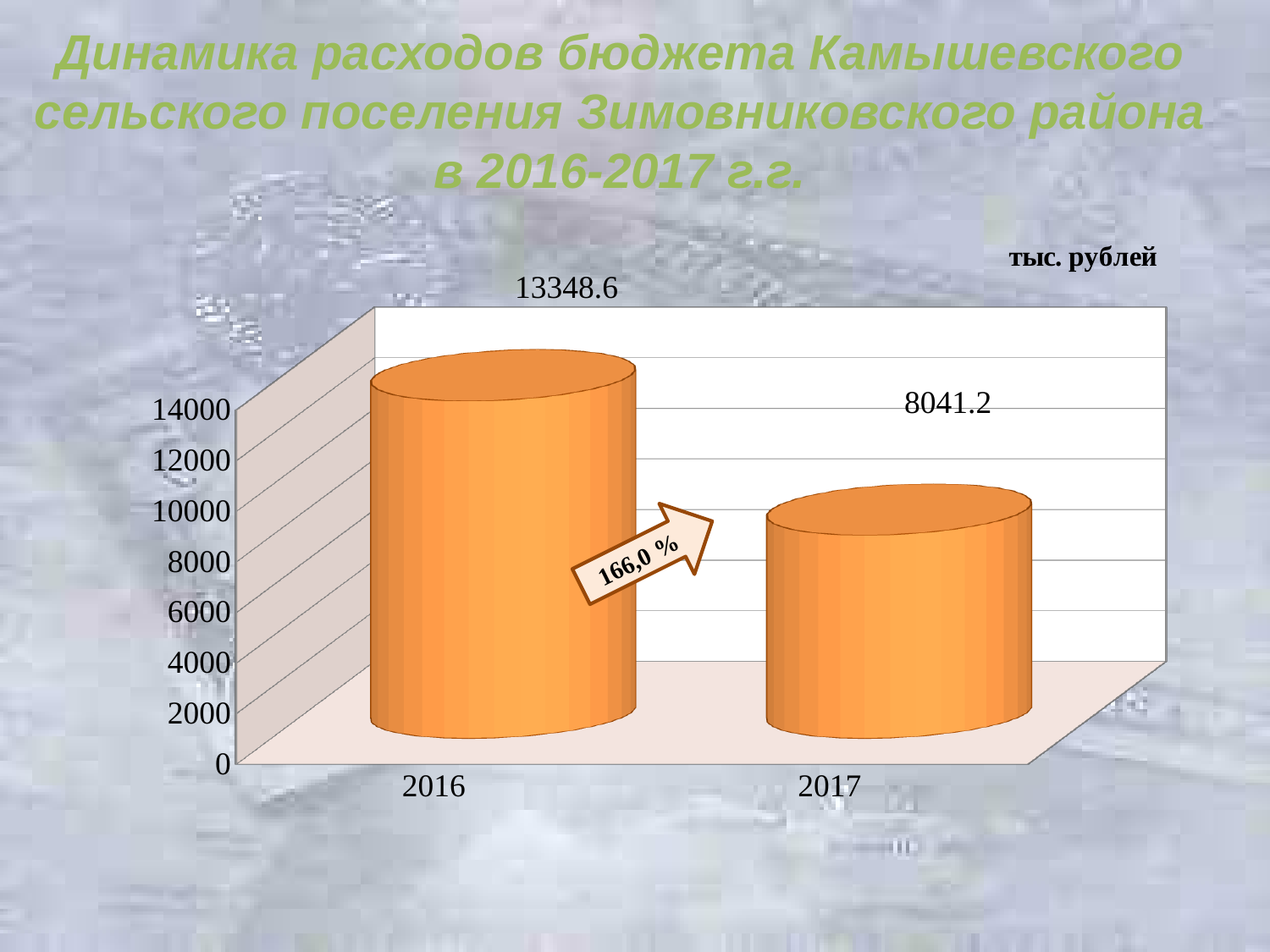
Is the value for 2016 greater or less than 12000? greater What is the value for 2017? 8041.2 Is the value for 2017 greater or less than 10000? less What kind of chart is shown on the slide? bar chart How many years are shown on the chart? 2 Which year has the lowest value? 2017 What is the difference between the values for 2016 and 2017? 5307.4 Do the values rise or fall from 2016 to 2017? fall Which is larger, the value for 2016 or the value for 2017? 2016 What unit is indicated above the chart? тыс. рублей Which year has the highest value? 2016 What is the value for 2016? 13348.6